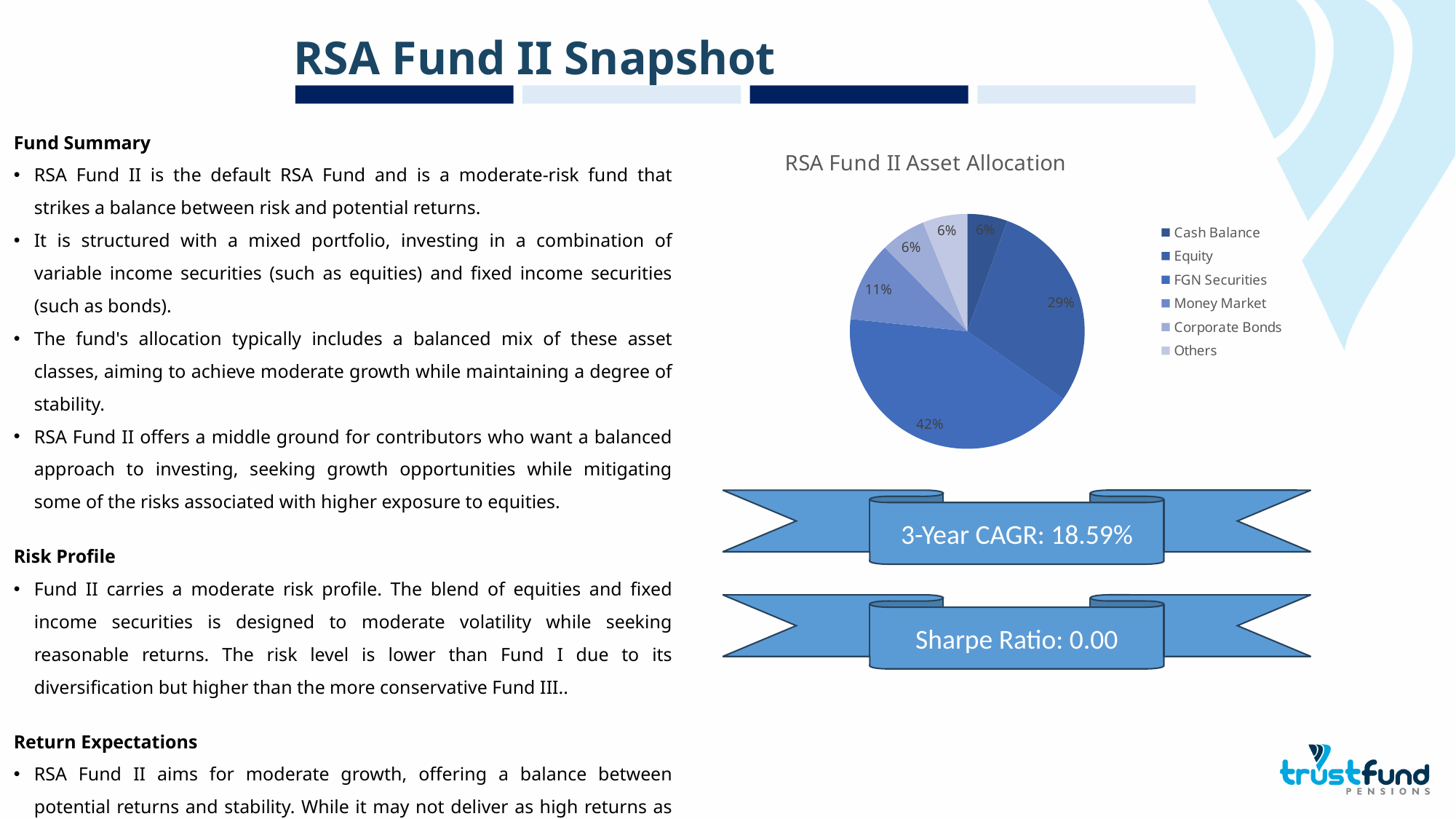
Which is larger, the Equity share or the Money Market share? Equity Which asset class has the largest share of the pie? FGN Securities What is the title of the chart? RSA Fund II Asset Allocation What type of chart is shown on the slide? pie chart What share of the pie does FGN Securities represent? 42% What is the difference between the Money Market share and the Corporate Bonds share? 5% What is the difference between the FGN Securities share and the Equity share? 13% What share of the pie does Equity represent? 29% Which legend entry is listed last in the pie chart's legend? Others What is the value shown for Money Market? 11% How many categories does the legend of the pie chart list? 6 What is the value shown for Cash Balance? 6%